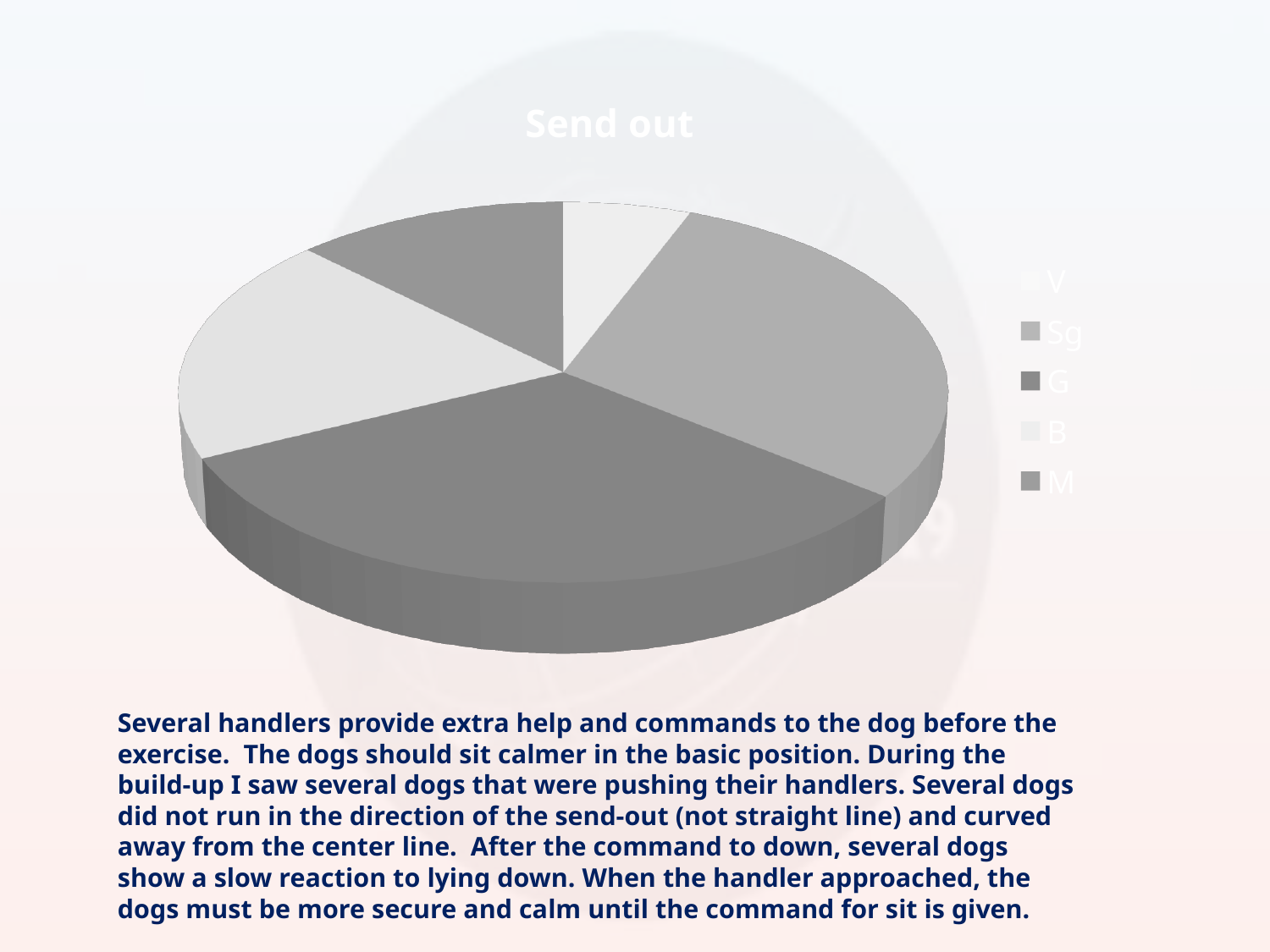
What is the title of the chart? Send out Which slice is larger, G or Sg? G How many slices does the pie chart have? 5 Which slice is larger, M or V? M Which slice is larger, B or M? B Which category has the largest slice of the pie? G Which category has the smallest slice of the pie? V What kind of chart is shown on the slide? pie chart How many entries does the legend list? 5 What are the legend entries listed for the chart, in order? V, Sg, G, B, M